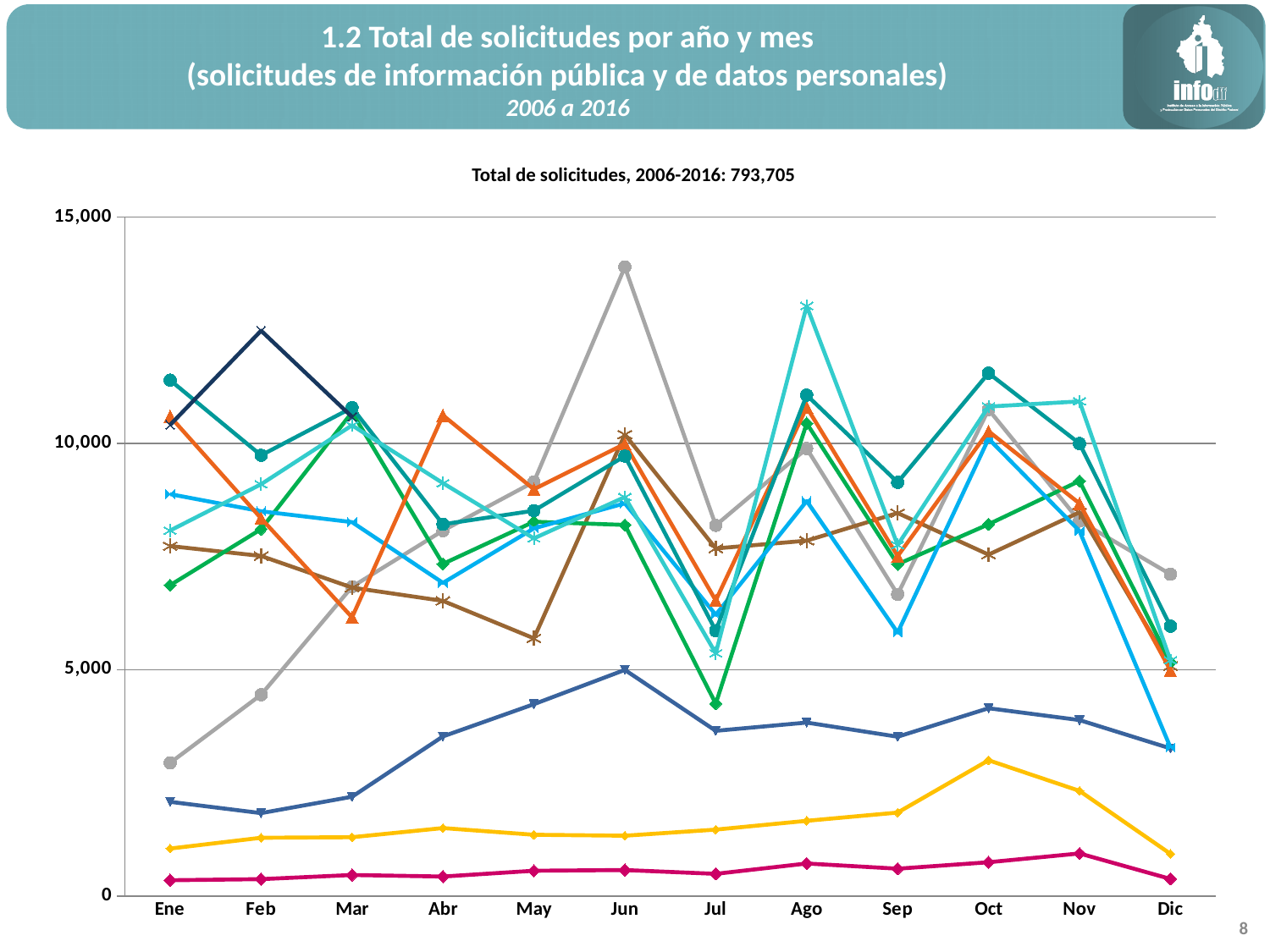
In which month does the single highest point on the chart occur? Jun What range of years does the slide title say the chart covers? 2006 a 2016 How many months are shown along the x axis of the chart? 12 What kind of chart is shown on the slide? line chart What is the first month label on the x axis of the chart? Ene What is the total number of solicitudes for 2006-2016 printed above the chart? 793,705 What is the highest value shown on the y axis of the chart? 15,000 Is the highest point on the chart greater or less than 10,000? greater